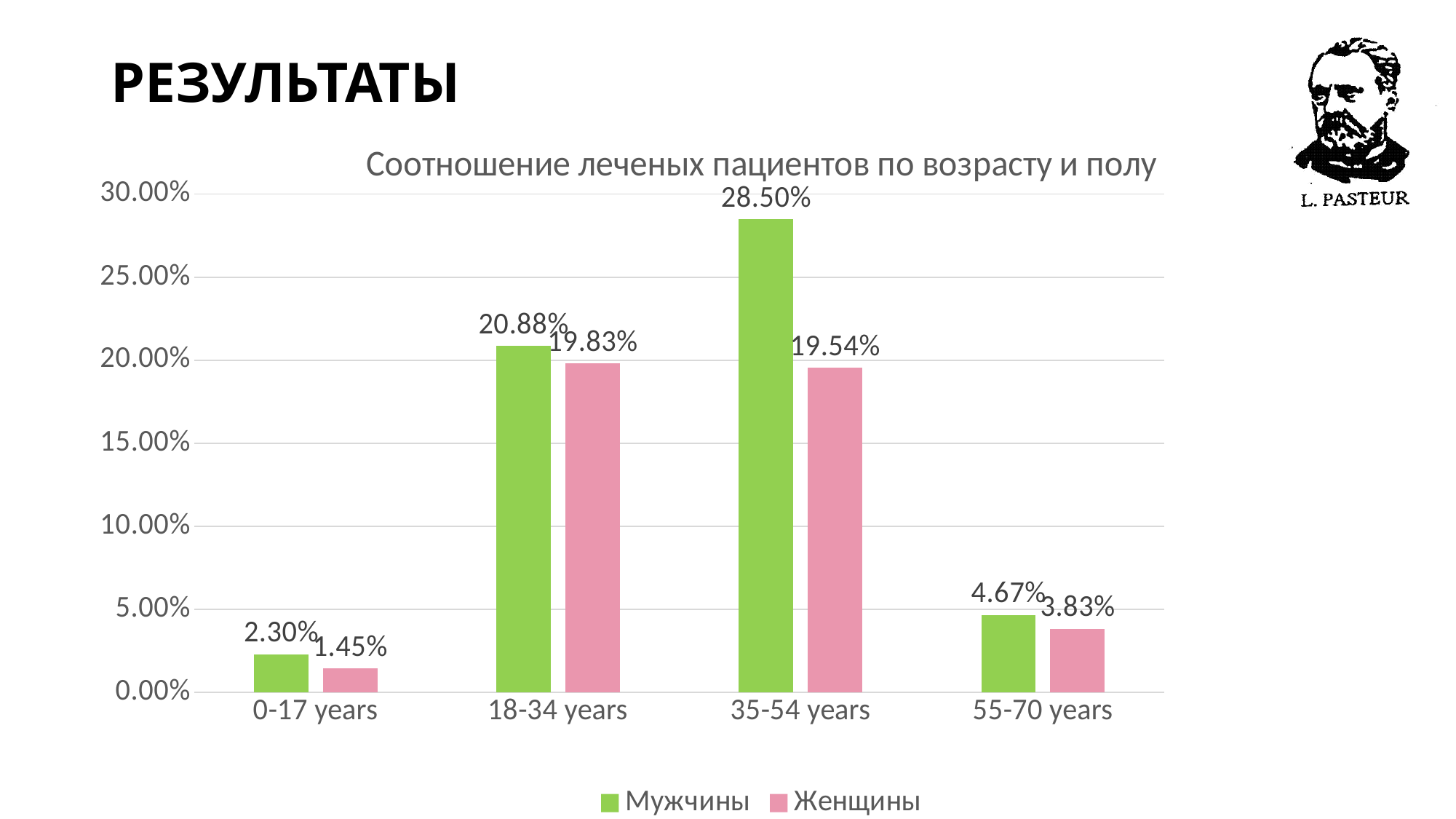
Which is larger in the 18-34 years category: the value for Мужчины or for Женщины? Мужчины How many series does the legend list? 2 Is the value for Мужчины in the 18-34 years category greater or less than 20.00%? greater Which age category has the highest value for Мужчины? 35-54 years What is the value for Мужчины in the 35-54 years category? 28.50% What is the value for Мужчины in the 0-17 years category? 2.30% How many age categories are shown on the x axis? 4 What is the value for Женщины in the 55-70 years category? 3.83% What is the value for Женщины in the 18-34 years category? 19.83% Which age category has the lowest value for Женщины? 0-17 years What is the difference between the Мужчины and Женщины values in the 35-54 years category? 8.96% What type of chart is shown on the slide? Bar chart